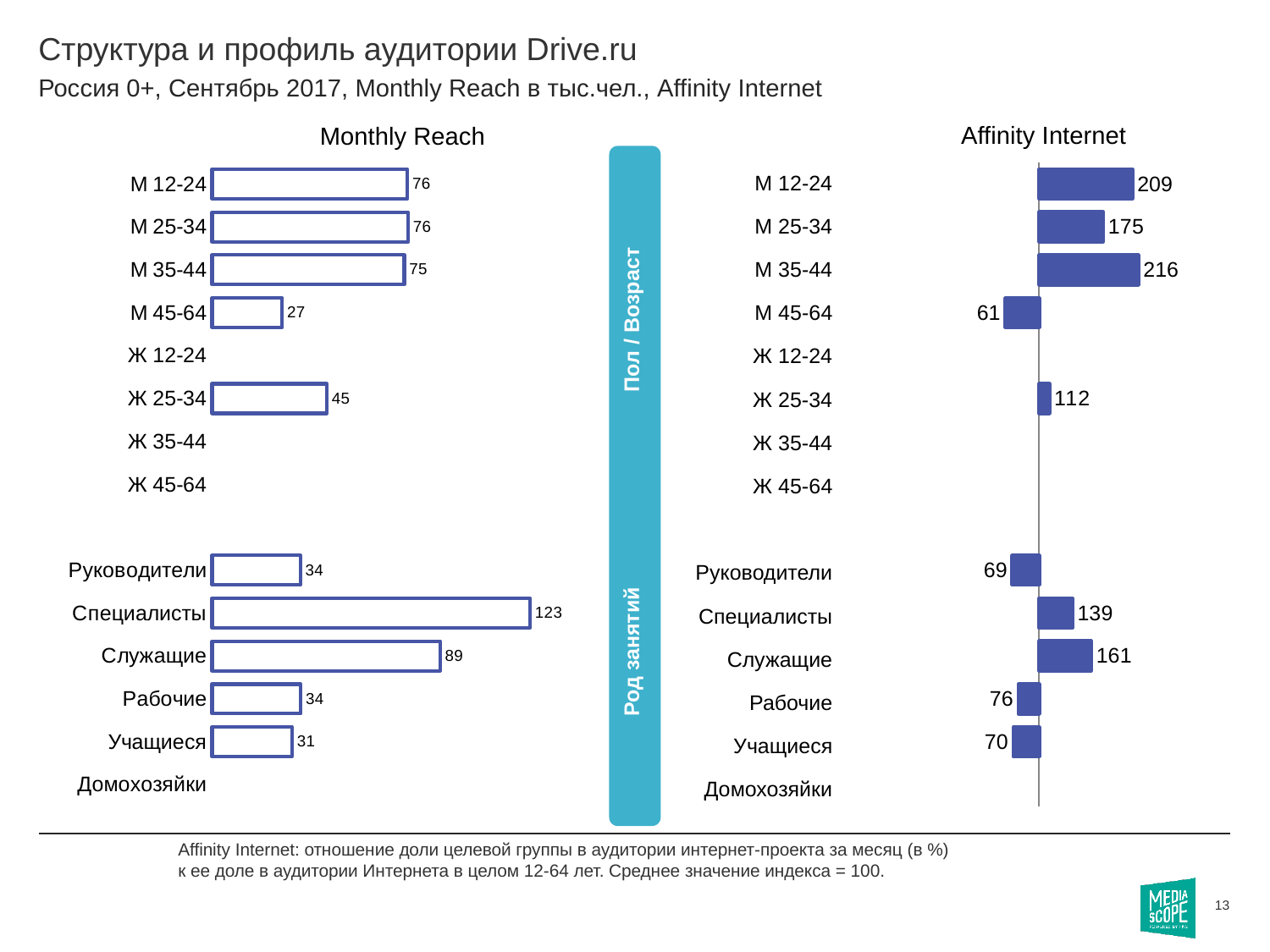
On the Monthly Reach chart, which is larger, Ж 25-34 or Учащиеся? Ж 25-34 On the Affinity Internet chart, what is the difference between М 12-24 and М 25-34? 34 On the Monthly Reach chart, which category has the highest value? Специалисты On the Affinity Internet chart, which category has the highest value? М 35-44 On the Monthly Reach chart, what is the value for Специалисты? 123 On the Affinity Internet chart, what is the value for М 35-44? 216 On the Affinity Internet chart, which is larger, Специалисты or Руководители? Специалисты On the Monthly Reach chart, what is the difference between Специалисты and Служащие? 34 What type of chart is the Affinity Internet chart? Bar chart On the Monthly Reach chart, what is the value for М 45-64? 27 On the Affinity Internet chart, which category has the lowest labelled value? М 45-64 On the Affinity Internet chart, what is the value for Служащие? 161